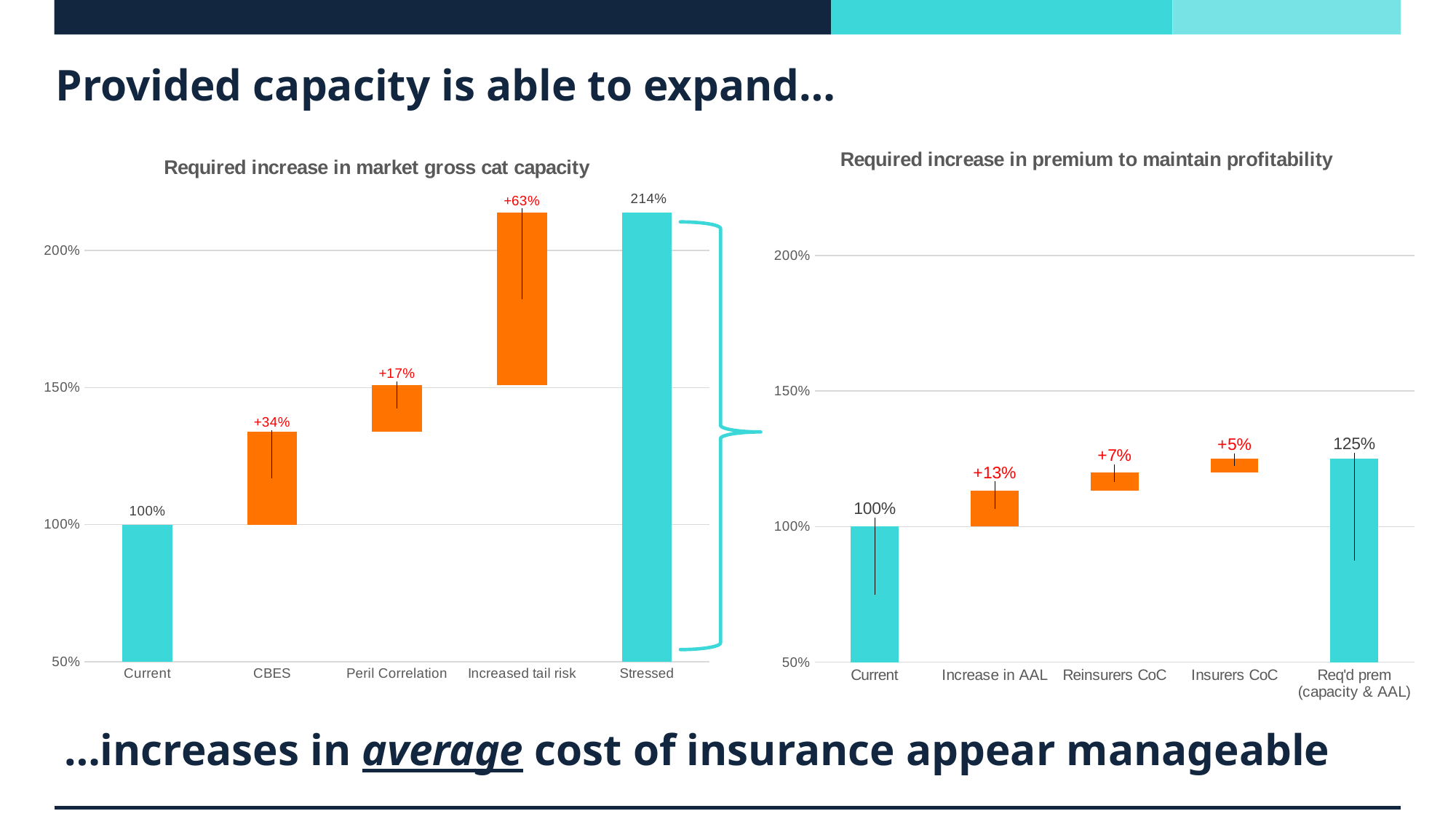
In the 'Required increase in premium to maintain profitability' chart, which of the orange increment steps is the smallest? Insurers CoC In the 'Required increase in market gross cat capacity' chart, which of the orange increment steps is the largest? Increased tail risk In the 'Required increase in market gross cat capacity' chart, how many percentage points higher is Stressed than Current? 114 percentage points How many categories are shown on the x axis of the 'Required increase in premium to maintain profitability' chart? 5 In the 'Required increase in premium to maintain profitability' chart, what increase is labelled for Increase in AAL? +13% What kind of chart is the 'Required increase in market gross cat capacity' chart? Bar chart (waterfall) In the 'Required increase in market gross cat capacity' chart, what is the value labelled for Stressed? 214% In the 'Required increase in premium to maintain profitability' chart, what is the value labelled for Req'd prem (capacity & AAL)? 125% In the 'Required increase in premium to maintain profitability' chart, is the value for Req'd prem (capacity & AAL) greater or less than 150%? less Which is larger: the Peril Correlation increase in the left chart or the Reinsurers CoC increase in the right chart? Peril Correlation In the 'Required increase in market gross cat capacity' chart, what increase is labelled for Increased tail risk? +63% In the 'Required increase in market gross cat capacity' chart, what increase is labelled for CBES? +34%